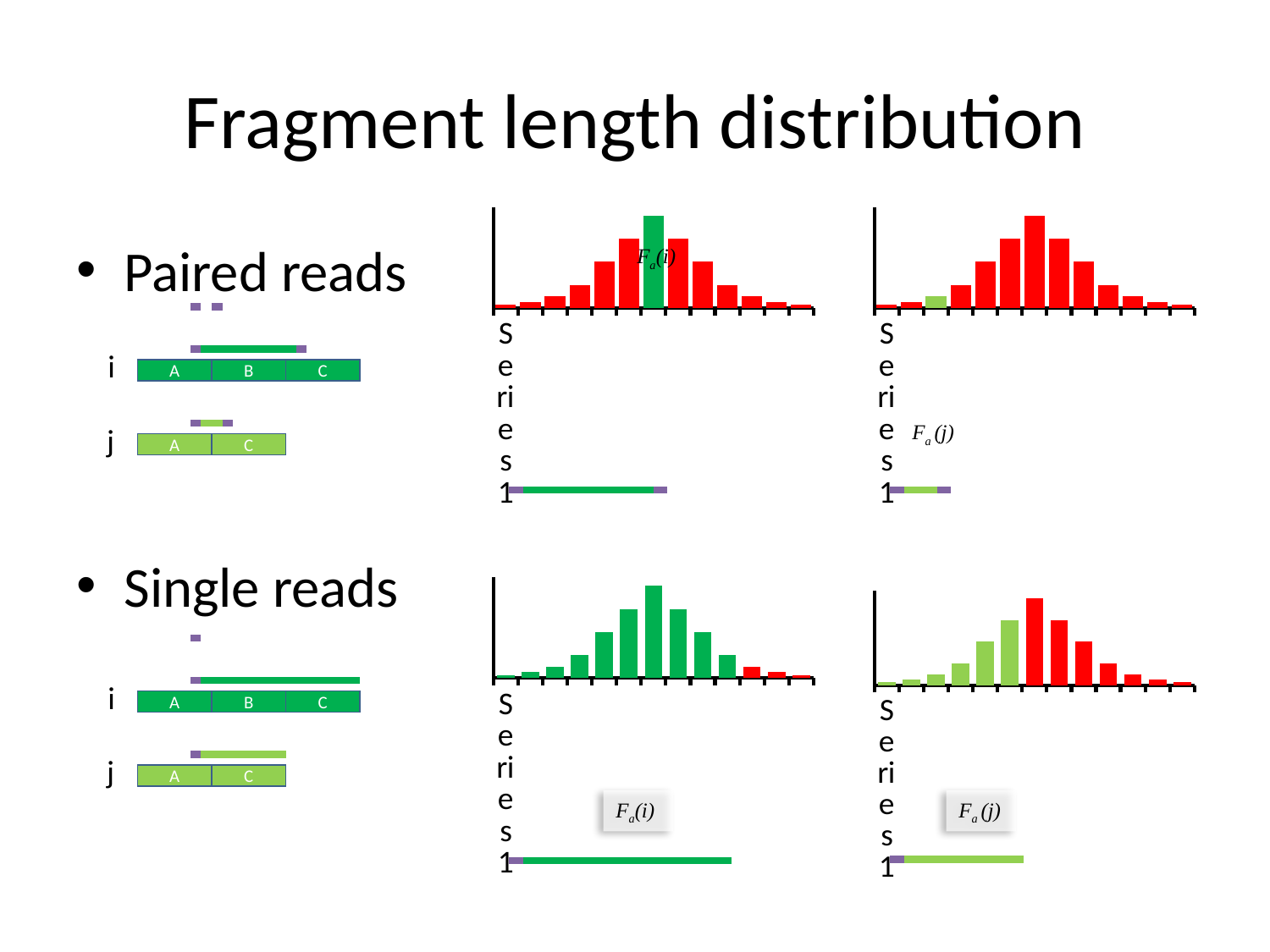
In the top-left chart, what colour is the tallest bar? green How many series does the legend of the bottom-right chart list? 1 What kind of chart is the bottom-right chart next to 'Single reads'? bar chart How many series does the legend of the top-left chart list? 1 In the top-right chart, do the bar heights rise, fall, or rise then fall along the x axis? rise then fall How many charts are shown on the slide? 4 In the bottom-left chart, do the bar heights rise, fall, or rise then fall along the x axis? rise then fall What kind of chart is the top-left chart next to 'Paired reads'? bar chart What is the legend entry shown under the top-right chart? Series 1